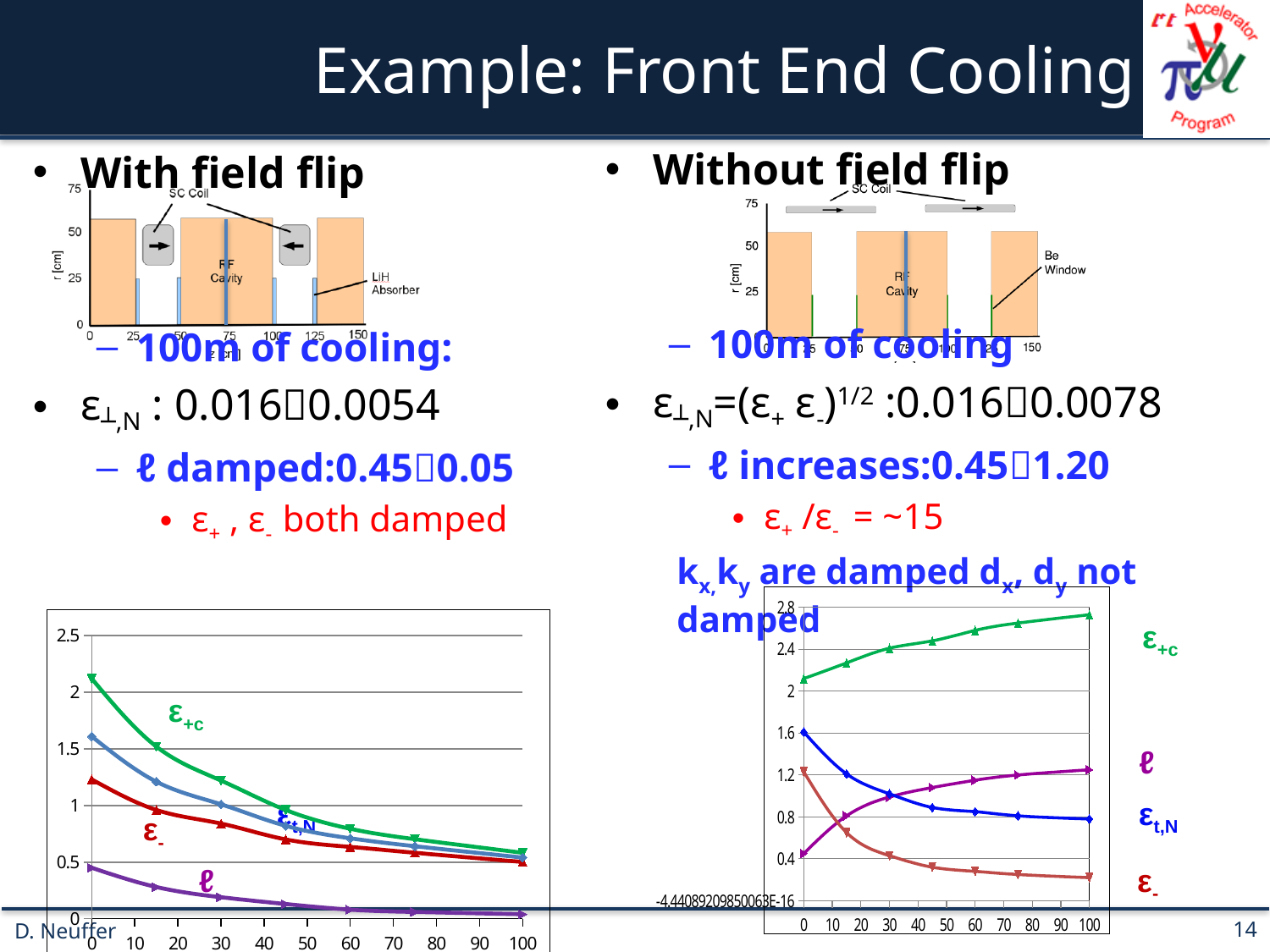
How many series are plotted on the bottom-right chart (without field flip)? 4 What kind of chart is the bottom-left chart (with field flip)? line chart On the bottom-right chart (without field flip), is the value of ε+c at x = 100 greater or less than 2.4? greater What kind of chart is the bottom-right chart (without field flip)? line chart On the bottom-right chart (without field flip), does the ε- series rise or fall as x increases from 0 to 100? fall On the bottom-left chart (with field flip), is the value of ℓ at x = 100 greater or less than 0.5? less On the bottom-right chart (without field flip), which is larger at x = 100, ℓ or εt,N? ℓ On the bottom-left chart (with field flip), does the ε+c series rise or fall as x increases from 0 to 100? fall On the bottom-left chart (with field flip), is the value of ε+c at x = 0 greater or less than 2? greater On the bottom-right chart (without field flip), does the ℓ series rise or fall as x increases from 0 to 100? rise What is the highest y-axis tick value shown on the bottom-right chart (without field flip)? 2.8 How many series are plotted on the bottom-left chart (with field flip)? 4